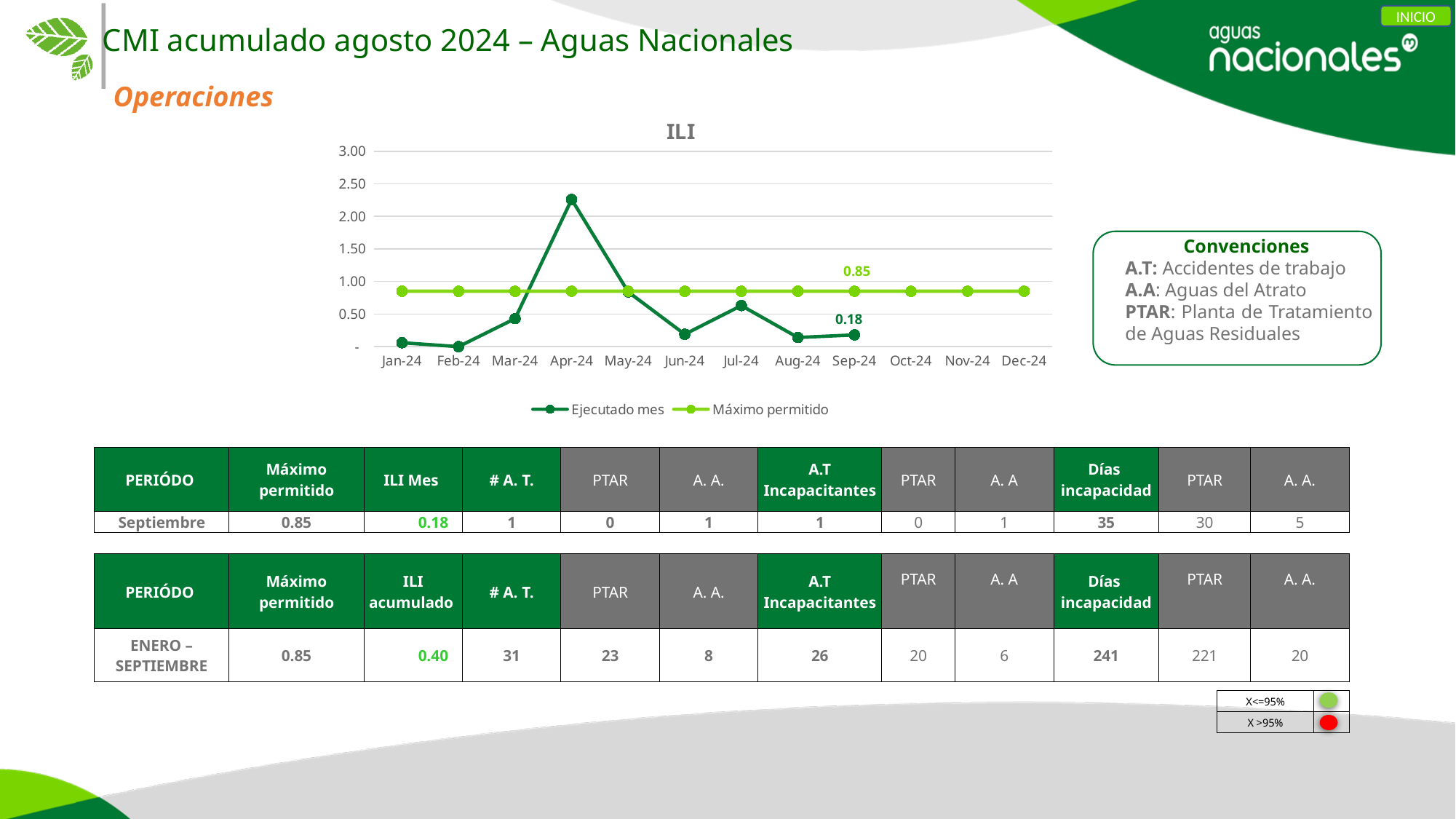
Does the Ejecutado mes line rise or fall from Apr-24 to Jun-24? fall Is the Ejecutado mes value for Apr-24 greater or less than 2.00? greater What is the value of the Máximo permitido line in the ILI chart? 0.85 Which month has the larger Ejecutado mes value, Apr-24 or Jul-24? Apr-24 What is the value of Ejecutado mes for Sep-24 in the ILI chart? 0.18 In which month does Ejecutado mes reach its highest value in the ILI chart? Apr-24 In which month does Ejecutado mes reach its lowest value in the ILI chart? Feb-24 What kind of chart is the ILI chart? line chart How many months are shown on the x axis of the ILI chart? 12 Is the Ejecutado mes value for Jan-24 greater or less than 0.50? less What is the difference between Máximo permitido and Ejecutado mes for Sep-24 in the ILI chart? 0.67 How many series does the legend of the ILI chart list? 2